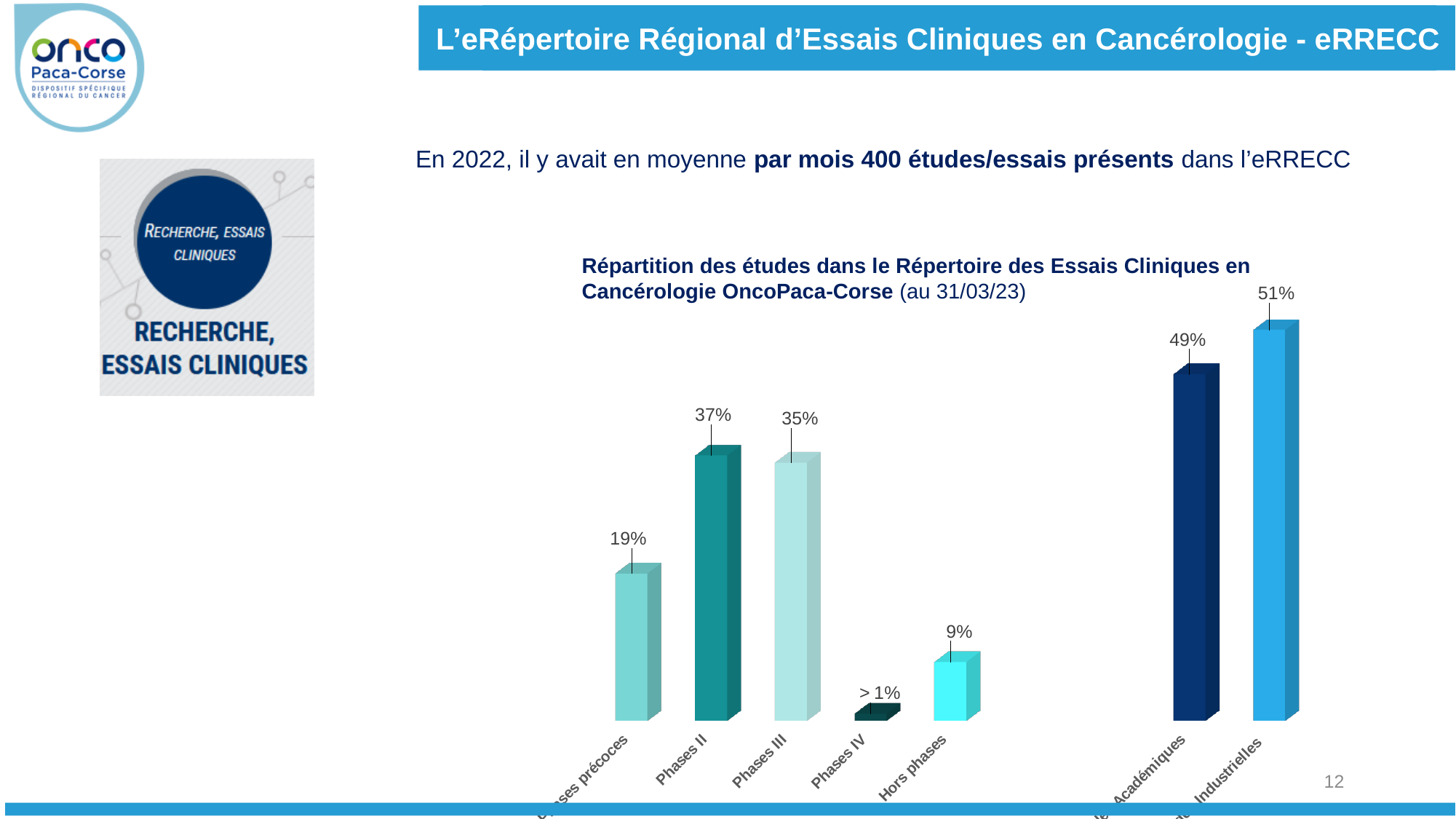
What percentage is shown for Hors phases? 9% What percentage is shown for Industrielles? 51% What percentage is shown for Académiques? 49% What is the difference in percentage points between Phases précoces and Hors phases? 10 What is the difference in percentage points between Phases II and Phases III? 2 What type of chart is shown on the slide? Bar chart What percentage is shown for Phases III? 35% Which is larger, the value for Académiques or the value for Industrielles? Industrielles Among the phase categories, which has the lowest percentage? Phases IV Among the phase categories (Phases précoces, Phases II, Phases III, Phases IV, Hors phases), which has the highest percentage? Phases II What date is given in the chart title for the data? 31/03/23 What percentage is shown for Phases II? 37%